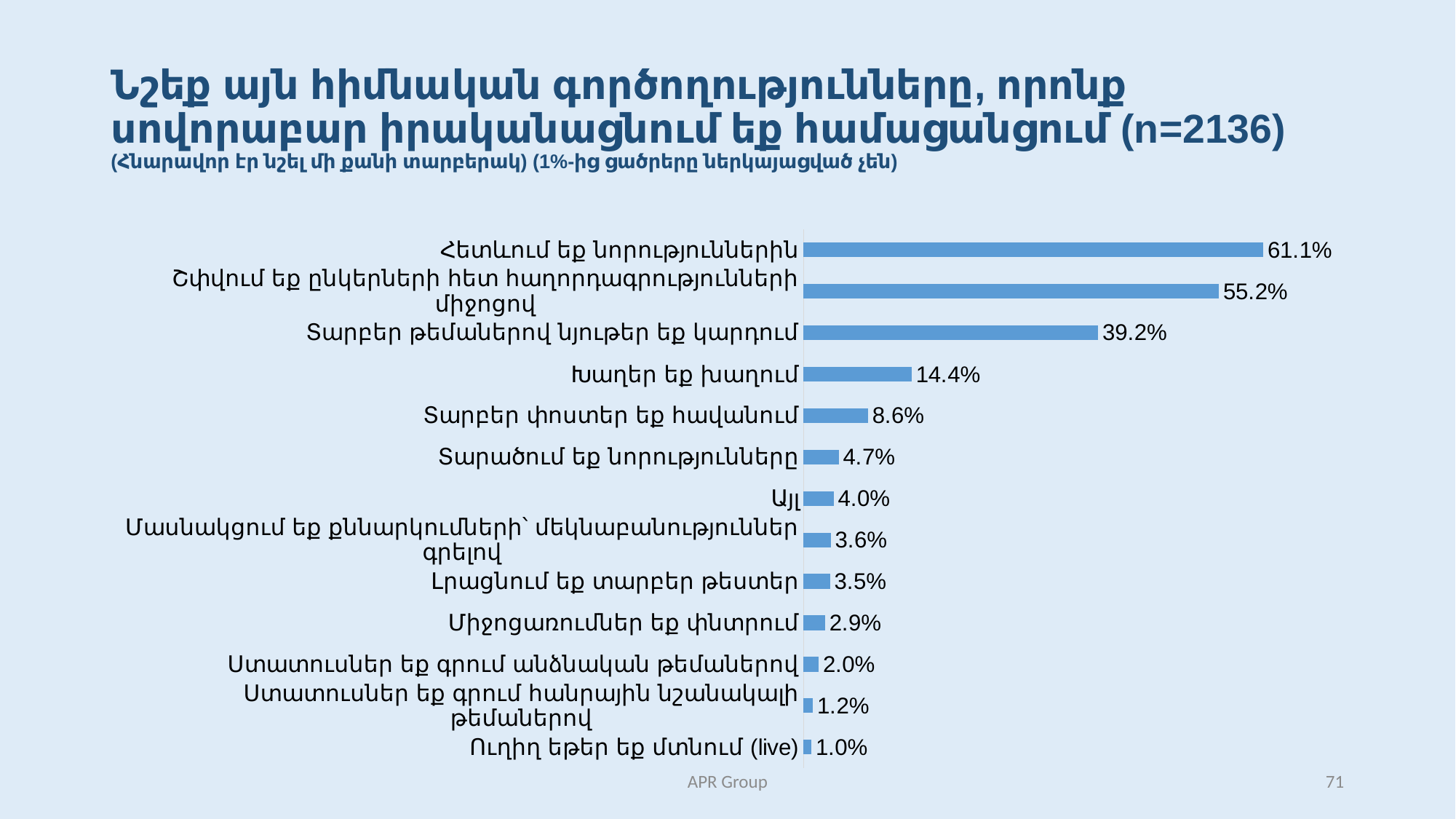
Which category has the highest value? Հետևում եք նորություններին What is the value for "Ուղիղ եթեր եք մտնում (live)"? 1.0% Which category has the lowest value? Ուղիղ եթեր եք մտնում (live) What is the difference between the values for "Հետևում եք նորություններին" and "Շփվում եք ընկերների հետ հաղորդագրությունների միջոցով"? 5.9% How many categories (activities) are plotted in the chart? 13 What type of chart is shown on the slide? Bar chart What is the difference between the values for "Տարածում եք նորությունները" and "Այլ"? 0.7% What is the value for "Խաղեր եք խաղում"? 14.4% What is the value for "Հետևում եք նորություններին"? 61.1% What is the value for "Տարբեր փոստեր եք հավանում"? 8.6% What sample size (n) is stated in the chart title? n=2136 Which is larger: the value for "Տարբեր թեմաներով նյութեր եք կարդում" or the value for "Խաղեր եք խաղում"? Տարբեր թեմաներով նյութեր եք կարդում